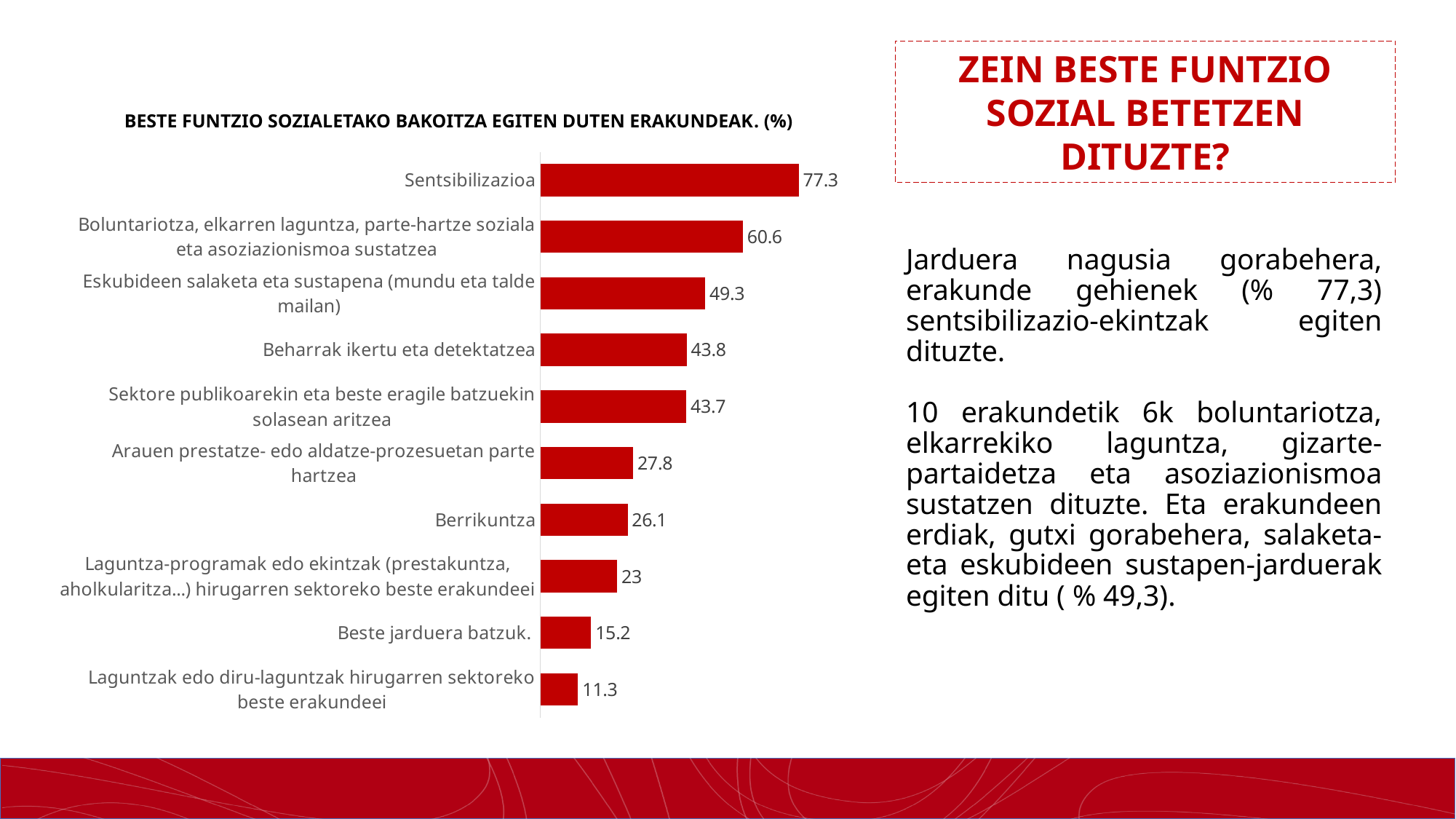
Which category has the lowest value? Laguntzak edo diru-laguntzak hirugarren sektoreko beste erakundeei What is the difference between the values for Sentsibilizazioa and Berrikuntza? 51.2 How many categories are shown in the chart? 10 What kind of chart is shown on the slide? Bar chart What colour are the bars in the chart? Red What is the value for Sentsibilizazioa? 77.3 Which category has the highest value? Sentsibilizazioa What is the value for Beharrak ikertu eta detektatzea? 43.8 What is the value for Berrikuntza? 26.1 What is the value for Beste jarduera batzuk.? 15.2 Which is larger, the value for Berrikuntza or the value for Beste jarduera batzuk.? Berrikuntza What is the title of the chart? BESTE FUNTZIO SOZIALETAKO BAKOITZA EGITEN DUTEN ERAKUNDEAK. (%)